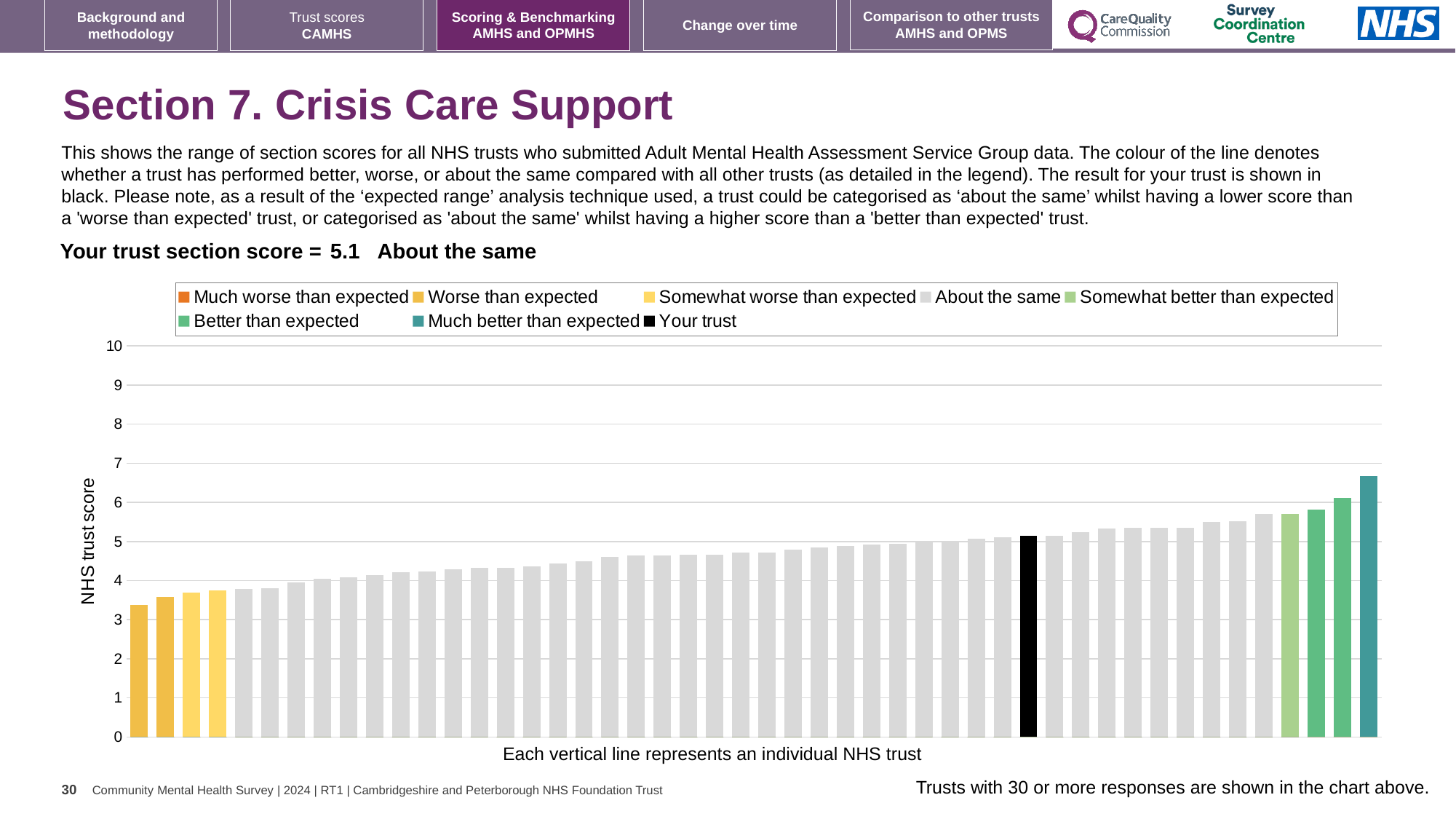
Is the value of the lowest bar greater or less than 4? less Is the value for your trust greater or less than 5? greater How many entries does the chart legend list? 8 What colour is the bar for your trust? Black What kind of chart is shown on the slide? Bar chart Which legend category does the highest-scoring trust belong to? Much better than expected How many trusts are shown in the 'Much better than expected' category? 1 Do the bar values rise or fall from left to right along the x axis? Rise Which category is your trust placed in for this section? About the same What is the label on the vertical axis? NHS trust score Is the value of the highest bar greater or less than 6? greater What is the section score for your trust? 5.1